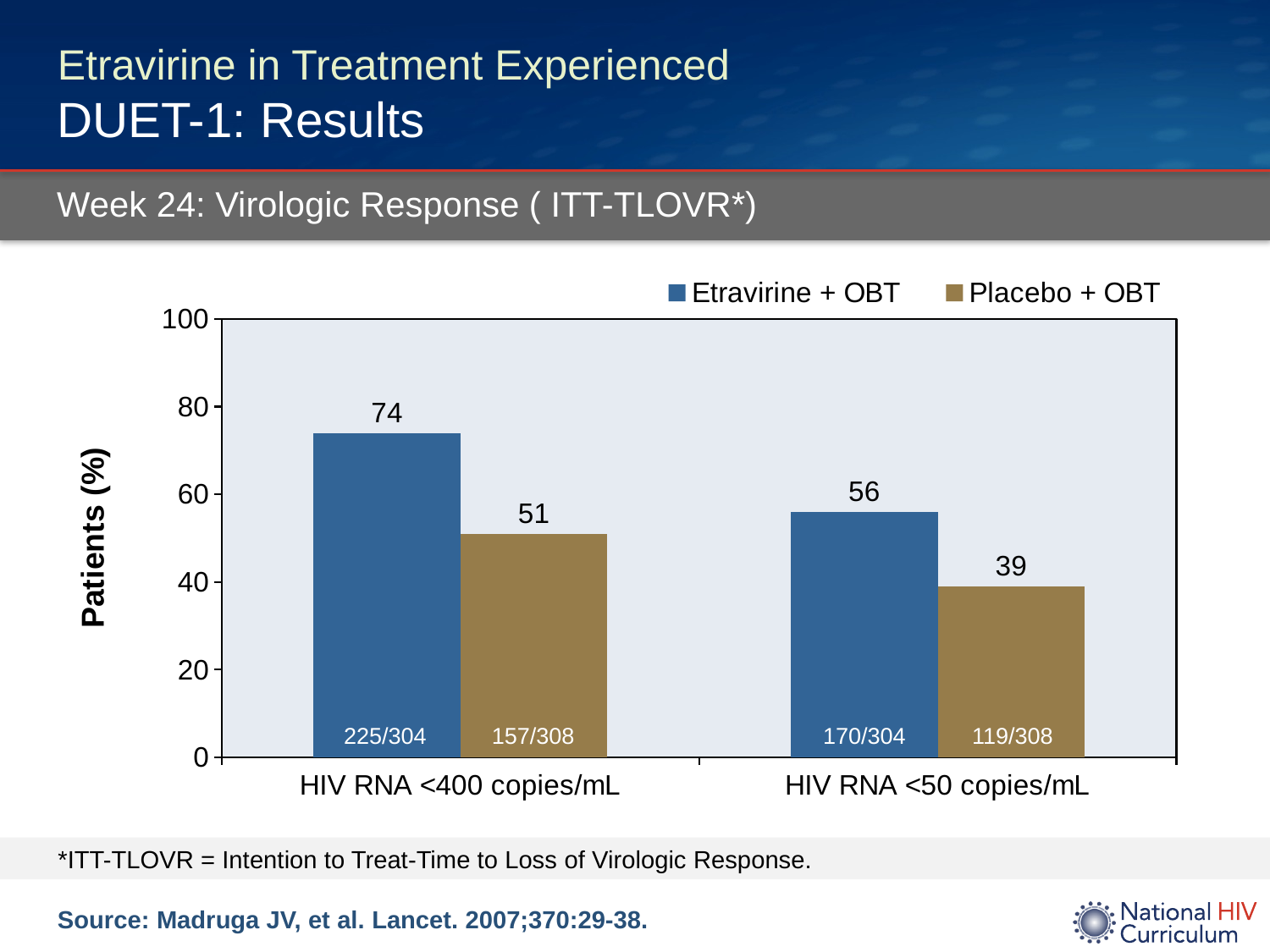
What is the difference between Etravirine + OBT and Placebo + OBT in the HIV RNA <50 copies/mL category? 17 What is the difference between Etravirine + OBT and Placebo + OBT in the HIV RNA <400 copies/mL category? 23 What kind of chart is shown on the slide? Bar chart Which bar has the lowest value on the chart? Placebo + OBT, HIV RNA <50 copies/mL What is the value for Etravirine + OBT in the HIV RNA <400 copies/mL category? 74 How many series does the legend list? 2 Which is larger in the HIV RNA <50 copies/mL category: Etravirine + OBT or Placebo + OBT? Etravirine + OBT Which bar has the highest value on the chart? Etravirine + OBT, HIV RNA <400 copies/mL How many categories are shown on the x axis? 2 What is the value for Placebo + OBT in the HIV RNA <400 copies/mL category? 51 What is the value for Placebo + OBT in the HIV RNA <50 copies/mL category? 39 What is the value for Etravirine + OBT in the HIV RNA <50 copies/mL category? 56